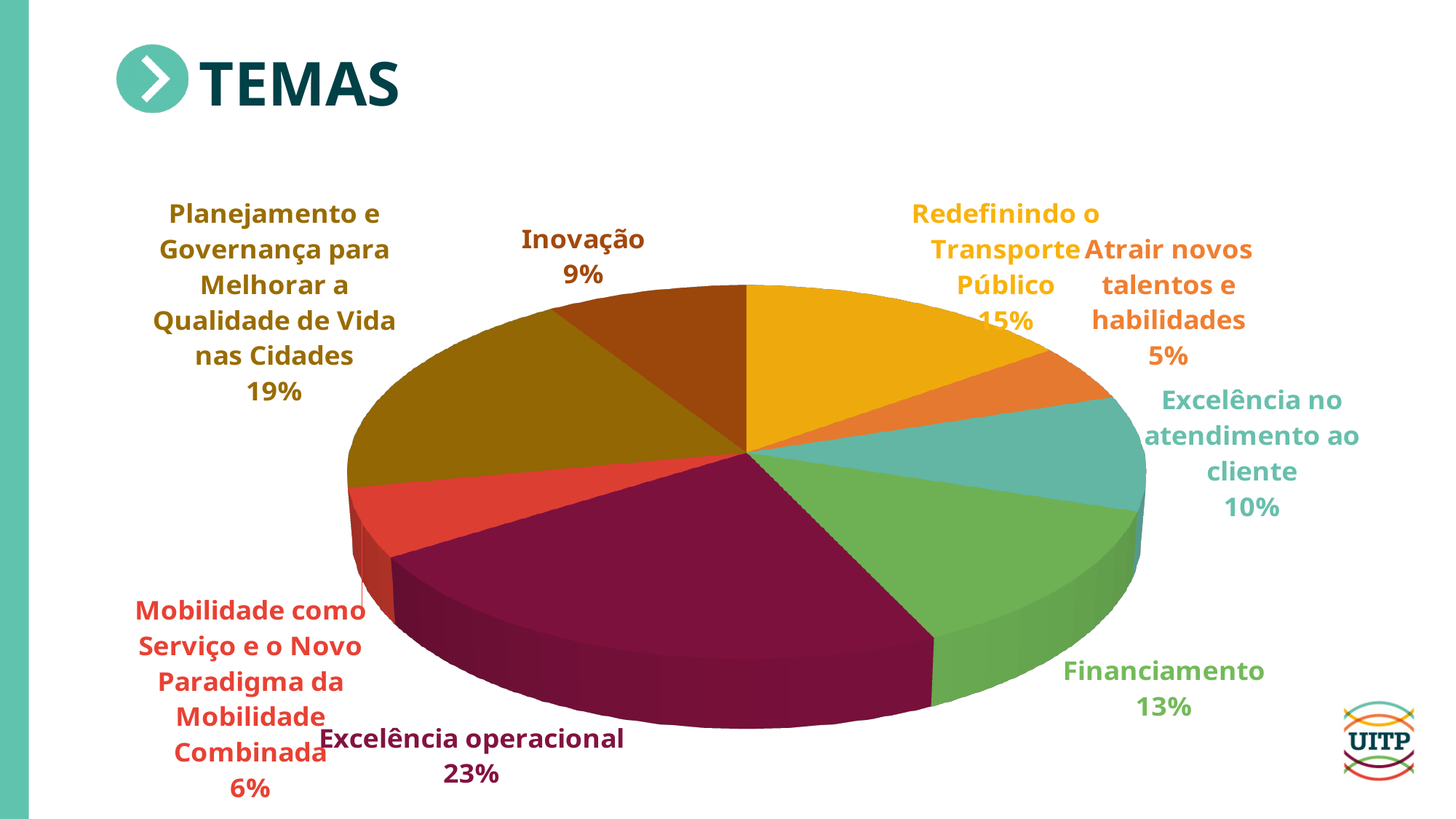
What percentage is shown for "Inovação"? 9% What share of the pie does "Excelência operacional" represent? 23% How many slices does the pie chart have? 8 Which theme has the largest share of the pie? Excelência operacional Which theme has the smallest share of the pie? Atrair novos talentos e habilidades Which is larger: the share for "Financiamento" or the share for "Excelência no atendimento ao cliente"? Financiamento What is the title of the slide containing the pie chart? TEMAS What is the difference in percentage points between "Excelência operacional" and "Planejamento e Governança para Melhorar a Qualidade de Vida nas Cidades"? 4 percentage points What percentage is shown for "Financiamento"? 13% What kind of chart is shown on the slide? Pie chart What percentage is shown for "Redefinindo o Transporte Público"? 15% What is the difference in percentage points between "Redefinindo o Transporte Público" and "Atrair novos talentos e habilidades"? 10 percentage points